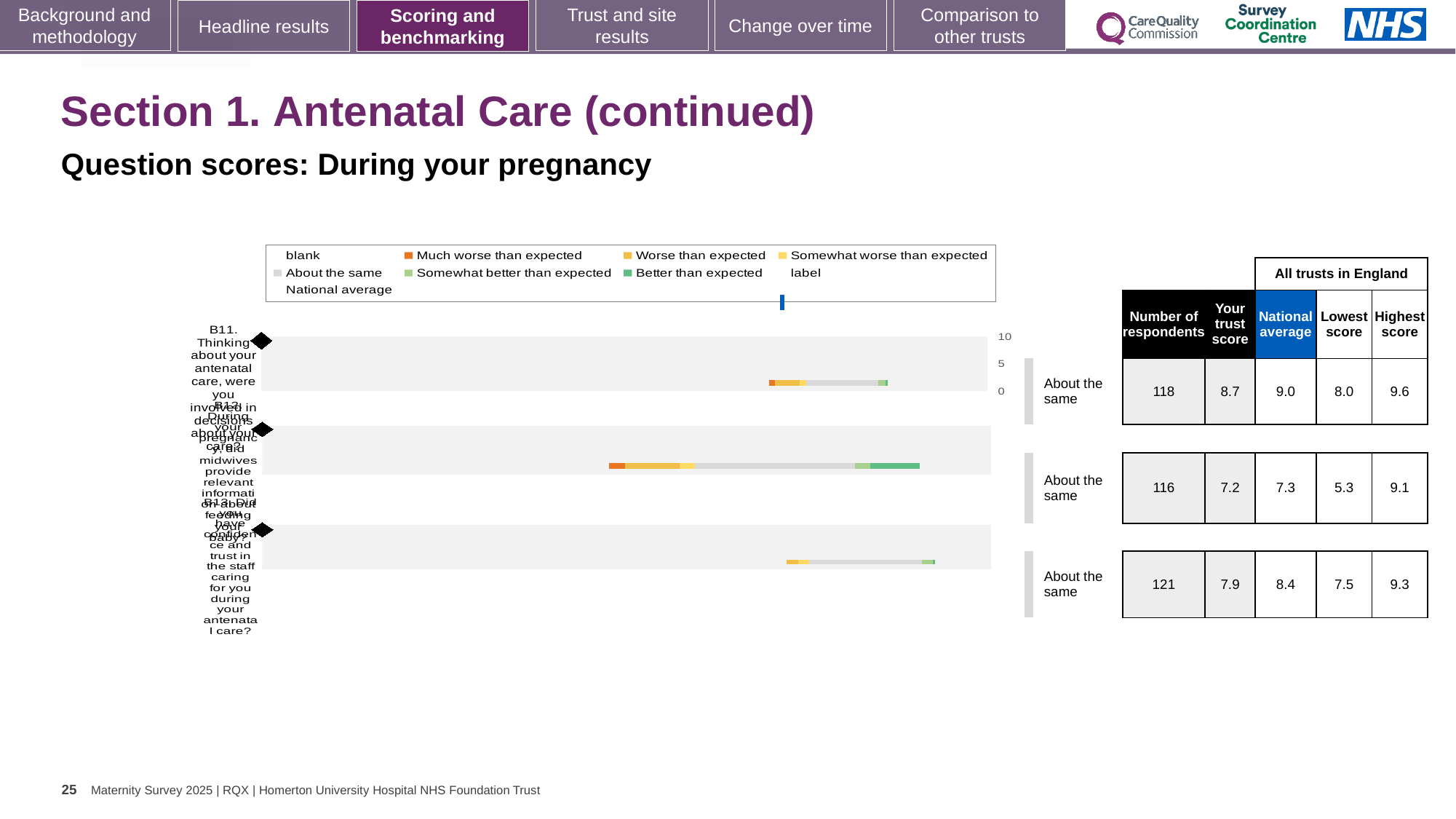
According to the table beside the chart, what is the national average for question B12? 7.3 In the chart legend, what does the blue vertical line represent? National average Which question has the lowest trust score in the table beside the chart? B12 According to the table beside the chart, how many respondents answered question B13? 121 What is the difference between the highest score and the lowest score for question B12 in the table beside the chart? 3.8 What kind of chart is shown on the slide? Bar chart For question B11, which is larger: the trust score or the national average? National average In the chart legend, what colour represents 'Much worse than expected'? Orange Which question has the highest trust score in the table beside the chart? B11 How many questions (bars) are plotted in the chart? 3 What benchmark category is shown for all three questions in the chart? About the same According to the table beside the chart, what is the trust score for question B11? 8.7